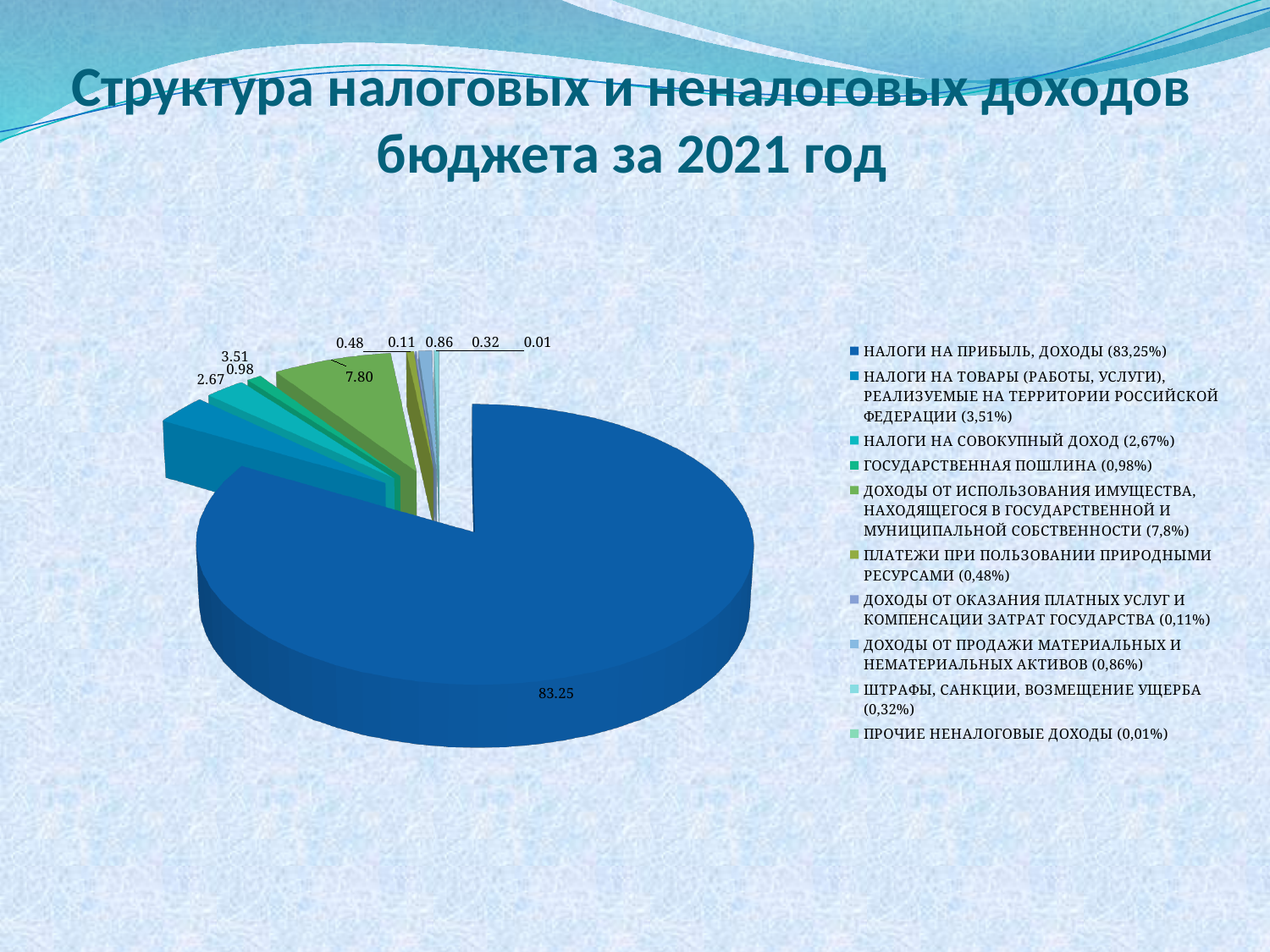
Which category has the smallest slice of the pie? ПРОЧИЕ НЕНАЛОГОВЫЕ ДОХОДЫ What is the difference between the values for НАЛОГИ НА ПРИБЫЛЬ, ДОХОДЫ and ДОХОДЫ ОТ ИСПОЛЬЗОВАНИЯ ИМУЩЕСТВА, НАХОДЯЩЕГОСЯ В ГОСУДАРСТВЕННОЙ И МУНИЦИПАЛЬНОЙ СОБСТВЕННОСТИ? 75.45 Which category has the largest slice of the pie? НАЛОГИ НА ПРИБЫЛЬ, ДОХОДЫ What is the difference between the values for НАЛОГИ НА ТОВАРЫ (РАБОТЫ, УСЛУГИ), РЕАЛИЗУЕМЫЕ НА ТЕРРИТОРИИ РОССИЙСКОЙ ФЕДЕРАЦИИ and НАЛОГИ НА СОВОКУПНЫЙ ДОХОД? 0.84 What is the data label value for the slice ШТРАФЫ, САНКЦИИ, ВОЗМЕЩЕНИЕ УЩЕРБА? 0.32 Which is larger: the value for НАЛОГИ НА СОВОКУПНЫЙ ДОХОД or the value for ГОСУДАРСТВЕННАЯ ПОШЛИНА? НАЛОГИ НА СОВОКУПНЫЙ ДОХОД How many slices does the pie chart have? 10 What is the data label value for the slice НАЛОГИ НА ПРИБЫЛЬ, ДОХОДЫ? 83.25 What is the data label value for the slice ДОХОДЫ ОТ ИСПОЛЬЗОВАНИЯ ИМУЩЕСТВА, НАХОДЯЩЕГОСЯ В ГОСУДАРСТВЕННОЙ И МУНИЦИПАЛЬНОЙ СОБСТВЕННОСТИ? 7.80 What is the title of the slide containing the chart? Структура налоговых и неналоговых доходов бюджета за 2021 год What share of the pie does the slice ГОСУДАРСТВЕННАЯ ПОШЛИНА represent, according to the legend? 0,98% What kind of chart is shown on the slide? Pie chart